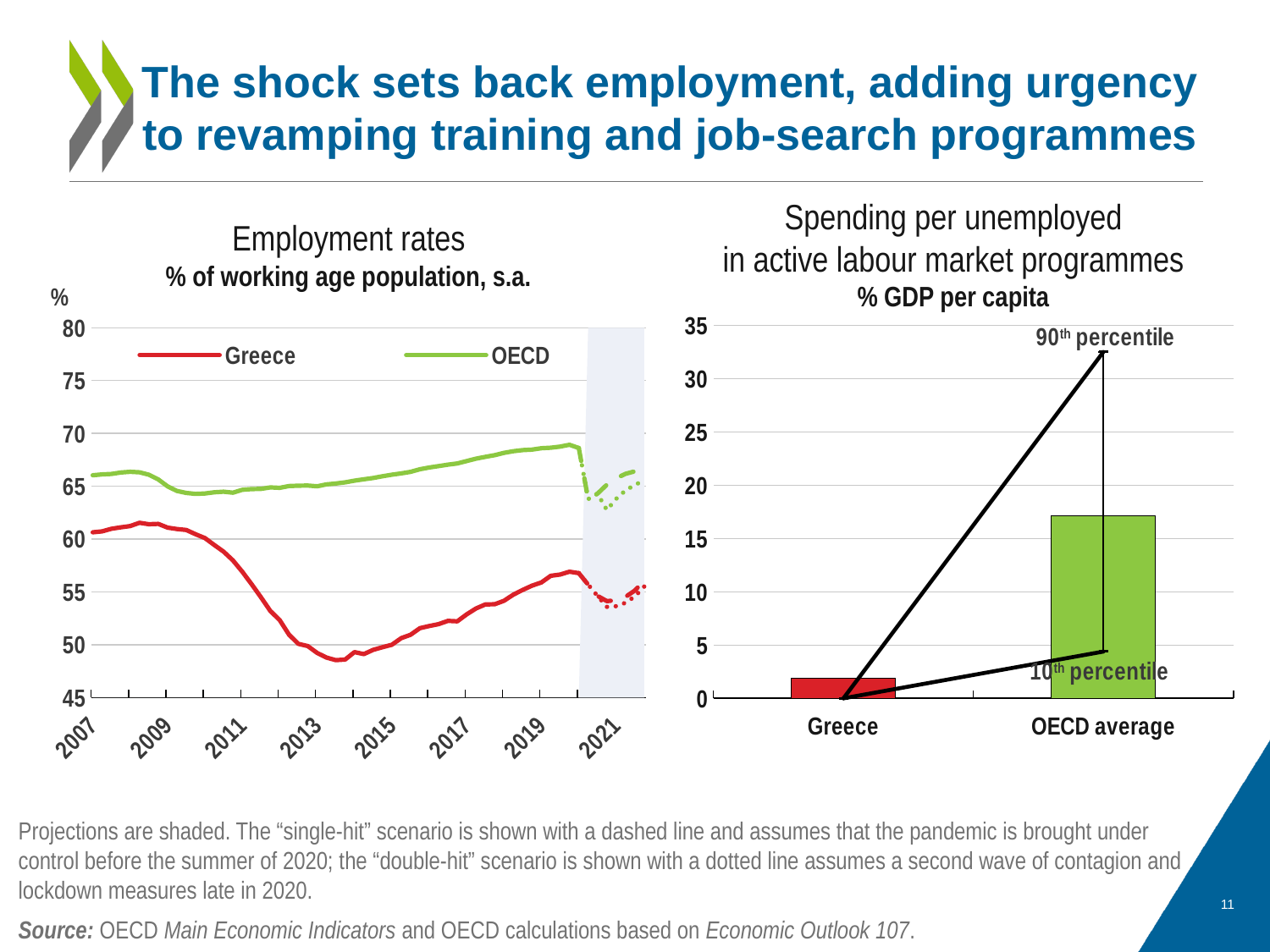
In the 'Employment rates' chart, does the Greece line rise or fall between 2009 and 2013? fall In the 'Employment rates' chart, does the OECD line rise or fall between 2013 and 2019? rise In the 'Spending per unemployed in active labour market programmes' chart, is the value for Greece greater or less than 5? less In the 'Spending per unemployed in active labour market programmes' chart, which bar is taller, Greece or OECD average? OECD average In the 'Employment rates' chart, is the value for Greece in 2014 greater or less than 55? less In the 'Employment rates' chart, what colour is the Greece line? red What kind of chart is the 'Employment rates' chart on the left? line chart In the 'Employment rates' chart, is the value for OECD in 2019 greater or less than 65? greater What kind of chart is the 'Spending per unemployed in active labour market programmes' chart on the right? bar chart In the 'Employment rates' chart, how many series does the legend list? 2 In the 'Employment rates' chart, which series has the higher value in 2019, Greece or OECD? OECD